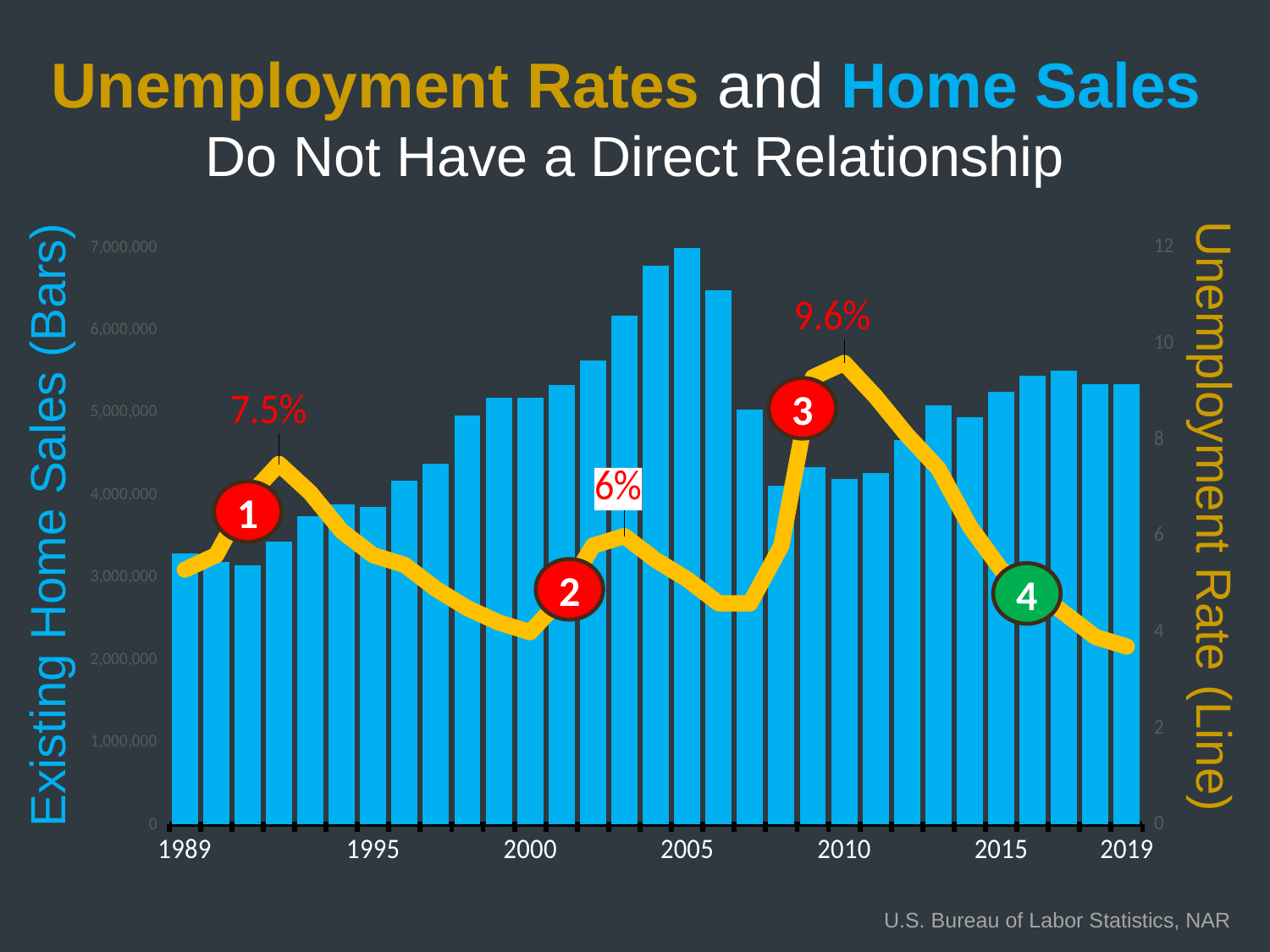
In which year does the unemployment rate line reach its highest point? 2010 Is the existing home sales value for 2005 greater or less than 6,000,000? greater What unemployment rate is labeled on the line at 2003? 6% What is the difference between the labeled unemployment rates of 9.6% and 7.5%? 2.1% What is the label on the right vertical axis? Unemployment Rate (Line) Which labeled unemployment rate is larger, the one at 2003 or the one at 2010? 2010 What kind of chart is shown on the slide? A bar chart combined with a line chart In which year is the existing home sales bar the tallest? 2005 Is the unemployment rate for 2019 greater or less than 4? less What unemployment rate is labeled on the line at 2010? 9.6% Does the unemployment rate line rise or fall from 2010 to 2019? fall What unemployment rate is labeled on the line at 1992? 7.5%